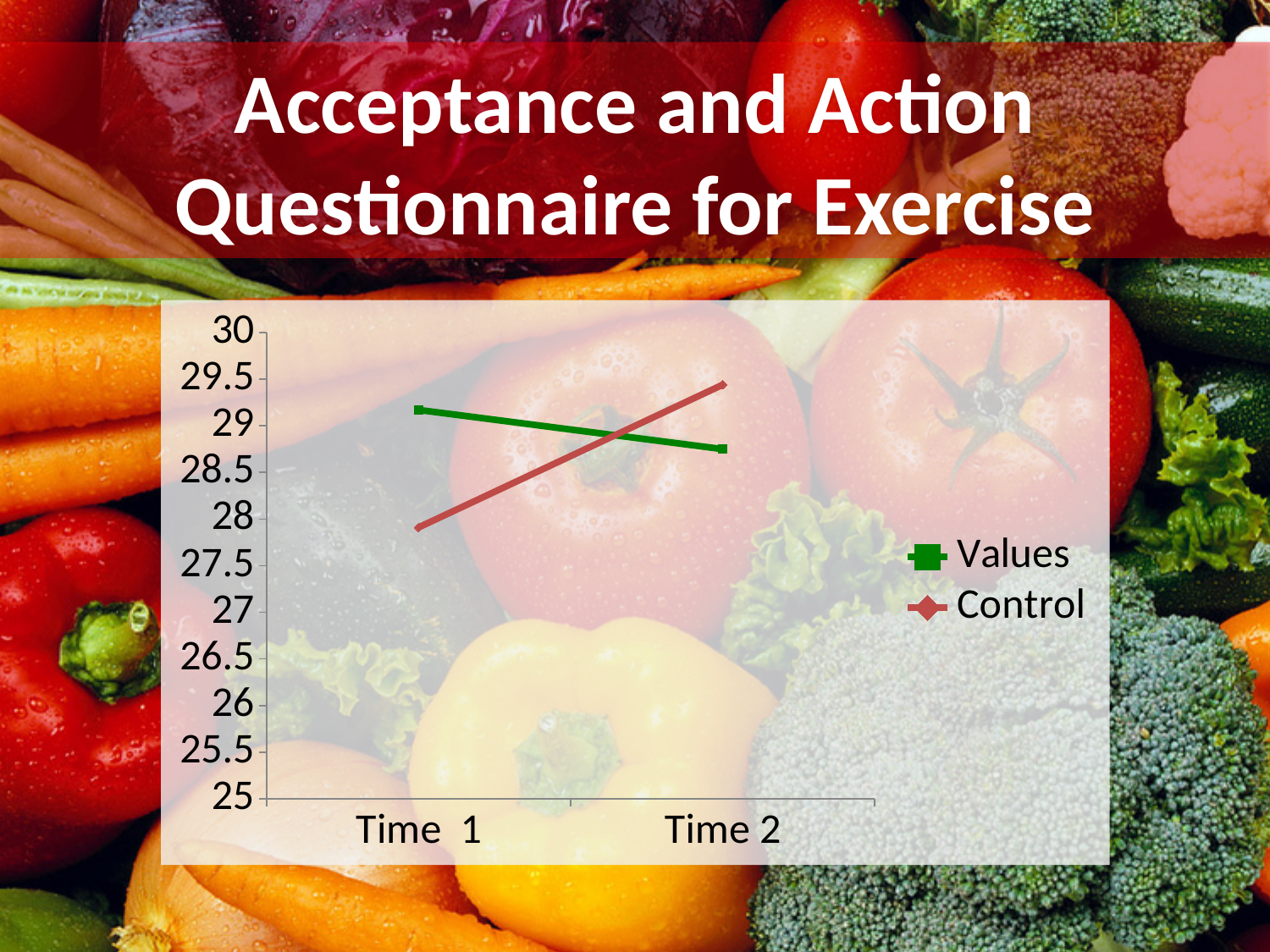
Is the value for Control at Time 2 greater or less than 29? greater What kind of chart is shown on the slide? line chart At Time 2, which series has the higher value, Values or Control? Control At Time 1, which series has the higher value, Values or Control? Values Does the Values line rise or fall from Time 1 to Time 2? fall Is the value for Control at Time 1 greater or less than 28.5? less What is the title of the slide containing the chart? Acceptance and Action Questionnaire for Exercise Is the value for Values at Time 2 greater or less than 29? less How many series does the legend list? 2 Which series is drawn in green? Values Does the Control line rise or fall from Time 1 to Time 2? rise How many time points are shown on the x axis? 2